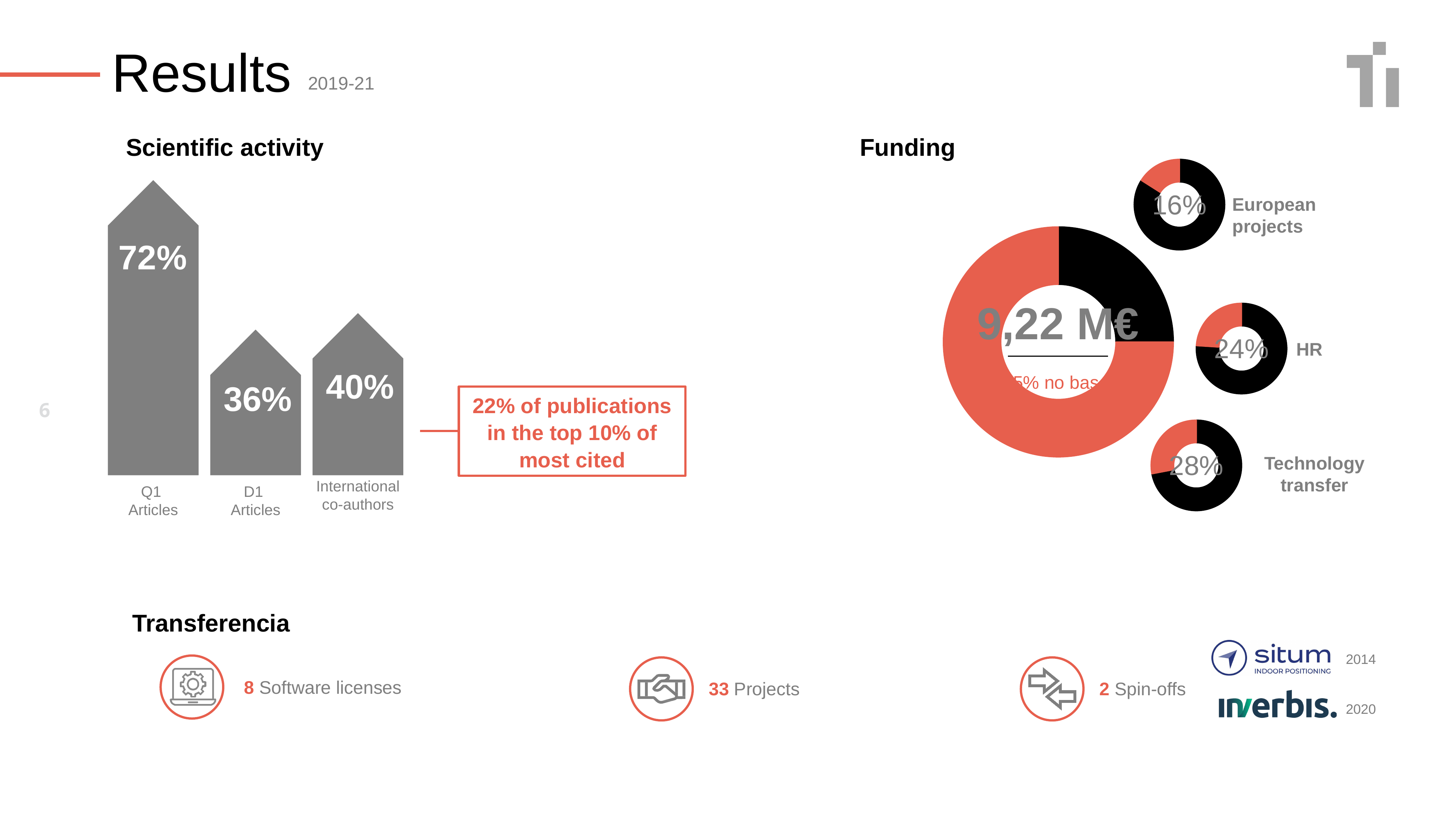
In the Scientific activity chart, what is the value for International co-authors? 40% In the Scientific activity chart, what is the value for Q1 Articles? 72% What kind of chart is the Scientific activity chart? Bar chart How many categories are shown in the Scientific activity chart? 3 In the Funding section, what percentage is shown in the small donut chart labelled European projects? 16% In the Funding section, what percentage is shown in the small donut chart labelled Technology transfer? 28% In the Scientific activity chart, which category has the lowest value? D1 Articles In the Scientific activity chart, which is larger: the value for International co-authors or the value for D1 Articles? International co-authors In the Funding section, what total amount is shown in the centre of the large donut chart? 9,22 M€ In the Scientific activity chart, what is the difference between the values for Q1 Articles and D1 Articles? 36% In the Scientific activity chart, what is the value for D1 Articles? 36% In the Scientific activity chart, which category has the highest value? Q1 Articles